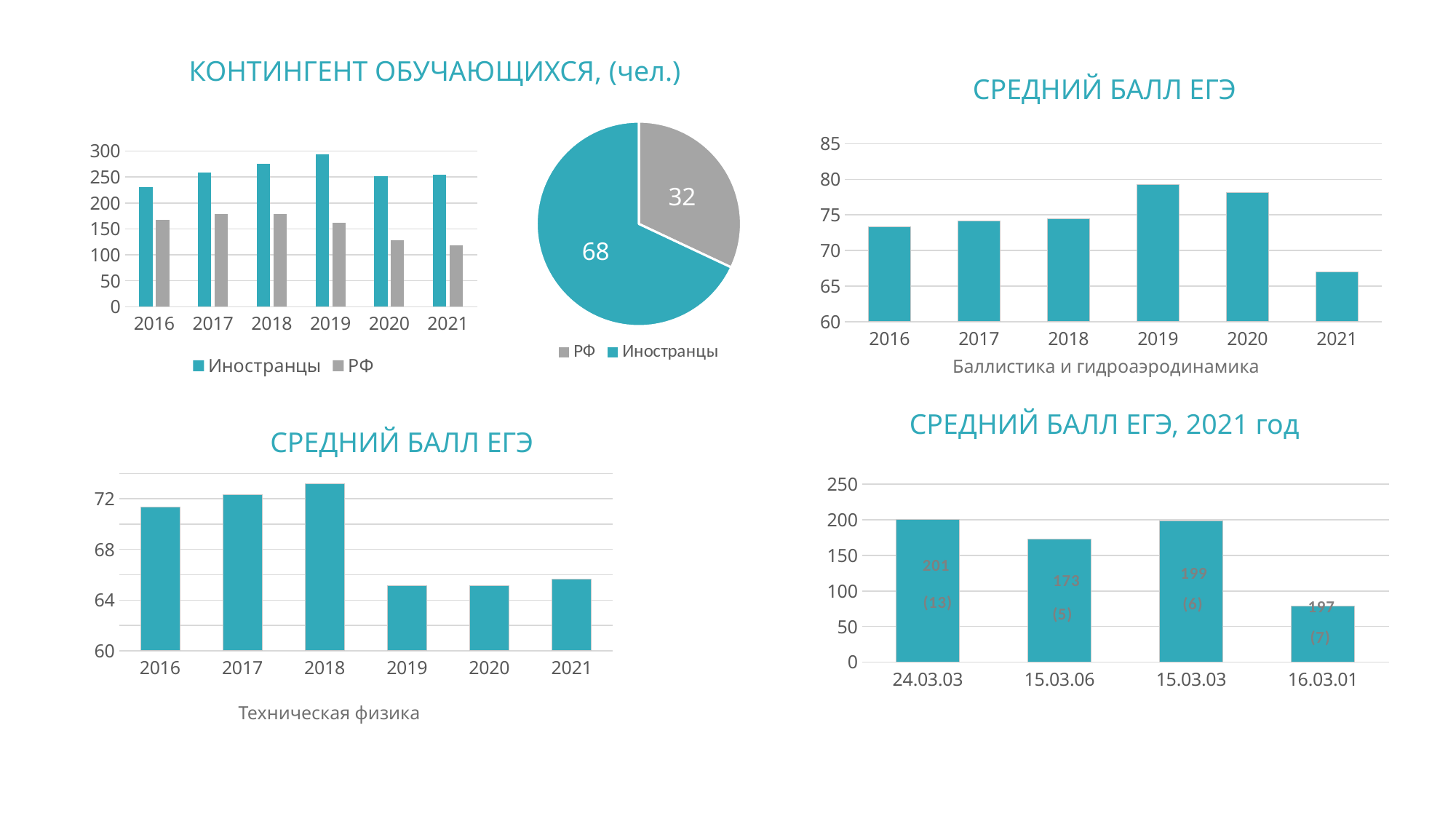
In the bar chart КОНТИНГЕНТ ОБУЧАЮЩИХСЯ, (чел.), how many years are shown on the x axis? 6 In the chart СРЕДНИЙ БАЛЛ ЕГЭ, 2021 год, how many categories are shown on the x axis? 4 In the chart СРЕДНИЙ БАЛЛ ЕГЭ for Техническая физика, which year has the highest value? 2018 In the chart СРЕДНИЙ БАЛЛ ЕГЭ for Баллистика и гидроаэродинамика, is the value for 2021 greater or less than 70? less In the chart СРЕДНИЙ БАЛЛ ЕГЭ for Баллистика и гидроаэродинамика, which year has the lowest value? 2021 In the pie chart under КОНТИНГЕНТ ОБУЧАЮЩИХСЯ, which slice is larger, РФ or Иностранцы? Иностранцы In the bar chart КОНТИНГЕНТ ОБУЧАЮЩИХСЯ, (чел.), is the value for РФ in 2021 greater or less than 150? less In the chart СРЕДНИЙ БАЛЛ ЕГЭ, 2021 год, what value is shown for 15.03.06? 173 In the pie chart under КОНТИНГЕНТ ОБУЧАЮЩИХСЯ, what value is shown for Иностранцы? 68 In the bar chart КОНТИНГЕНТ ОБУЧАЮЩИХСЯ, (чел.), how many series does the legend list? 2 In the bar chart КОНТИНГЕНТ ОБУЧАЮЩИХСЯ, (чел.), is the value for Иностранцы in 2016 greater or less than 200? greater In the bar chart КОНТИНГЕНТ ОБУЧАЮЩИХСЯ, (чел.), which year has the highest value for Иностранцы? 2019